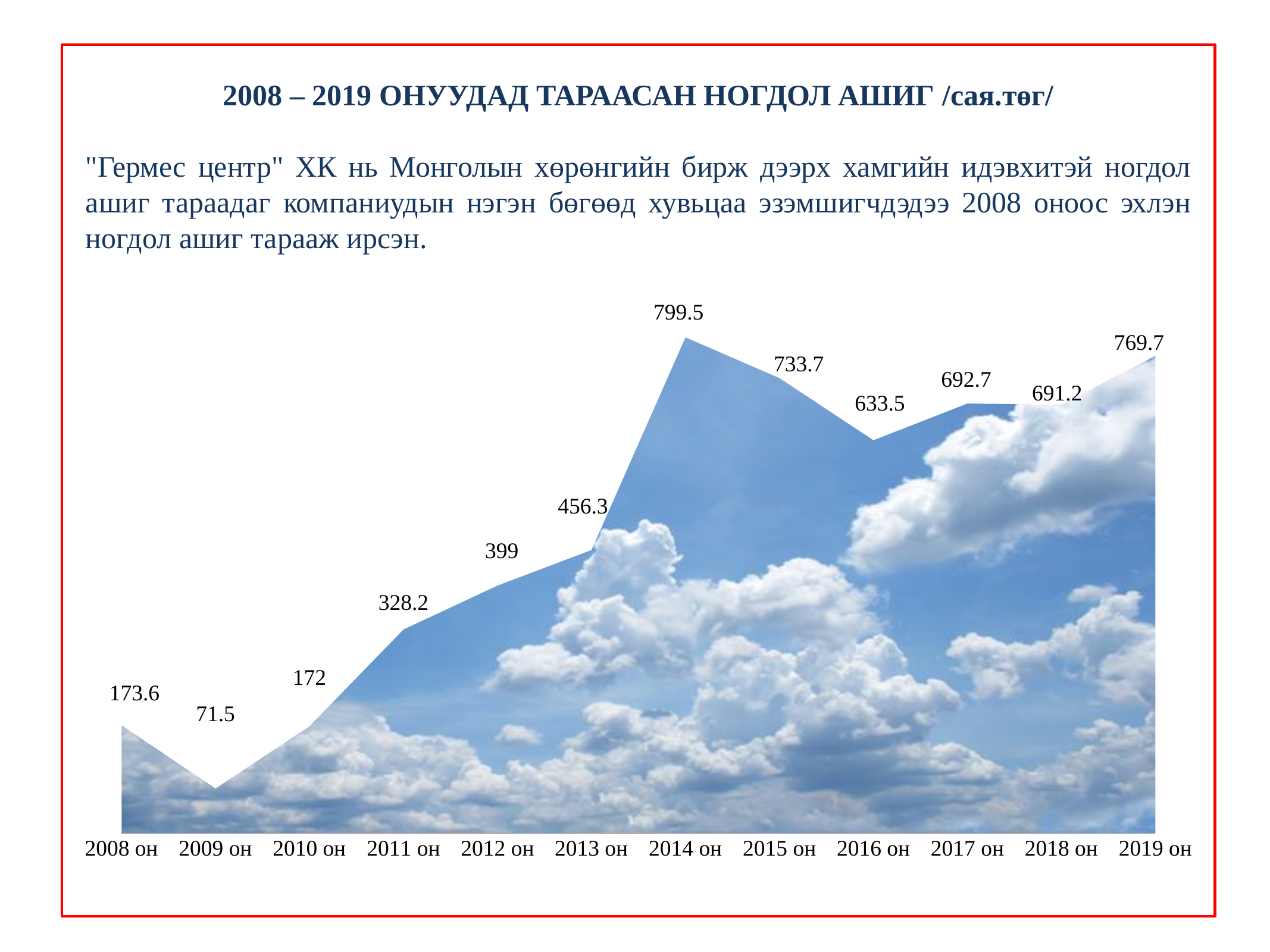
What is the value for 2012 он? 399 Which year has the lowest value? 2009 он What is the value for 2009 он? 71.5 What is the value for 2019 он? 769.7 Which is larger, the value for 2014 он or the value for 2019 он? 2014 он What is the difference between the values for 2014 он and 2015 он? 65.8 Which year has the highest value? 2014 он What kind of chart is shown on the slide? Area chart Do the values rise or fall from 2010 он to 2014 он? Rise What is the value for 2014 он? 799.5 What is the difference between the values for 2008 он and 2009 он? 102.1 How many years are shown on the x axis? 12